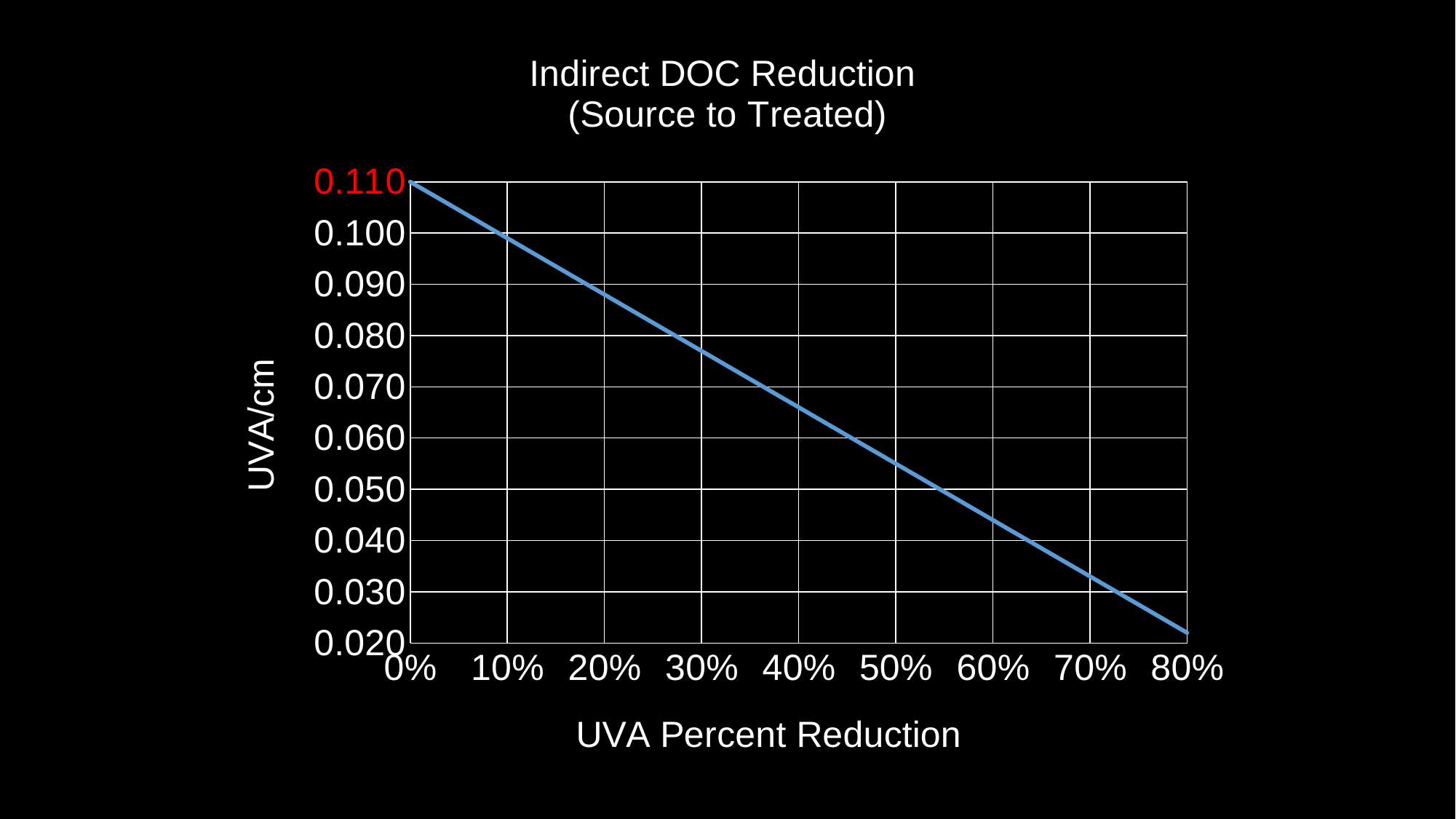
What kind of chart is shown on the slide? line chart Does the UVA/cm value rise or fall as UVA Percent Reduction increases? fall What is the label of the y axis? UVA/cm Is the UVA/cm value at 80% UVA Percent Reduction greater or less than 0.030? less What is the UVA/cm value at 0% UVA Percent Reduction? 0.110 Is the UVA/cm value at 40% UVA Percent Reduction greater or less than 0.060? greater Is the UVA/cm value at 60% UVA Percent Reduction greater or less than 0.040? greater What is the title of the chart? Indirect DOC Reduction (Source to Treated) Which UVA Percent Reduction value has the highest UVA/cm, 0% or 80%? 0% How many tick labels are shown on the x axis? 9